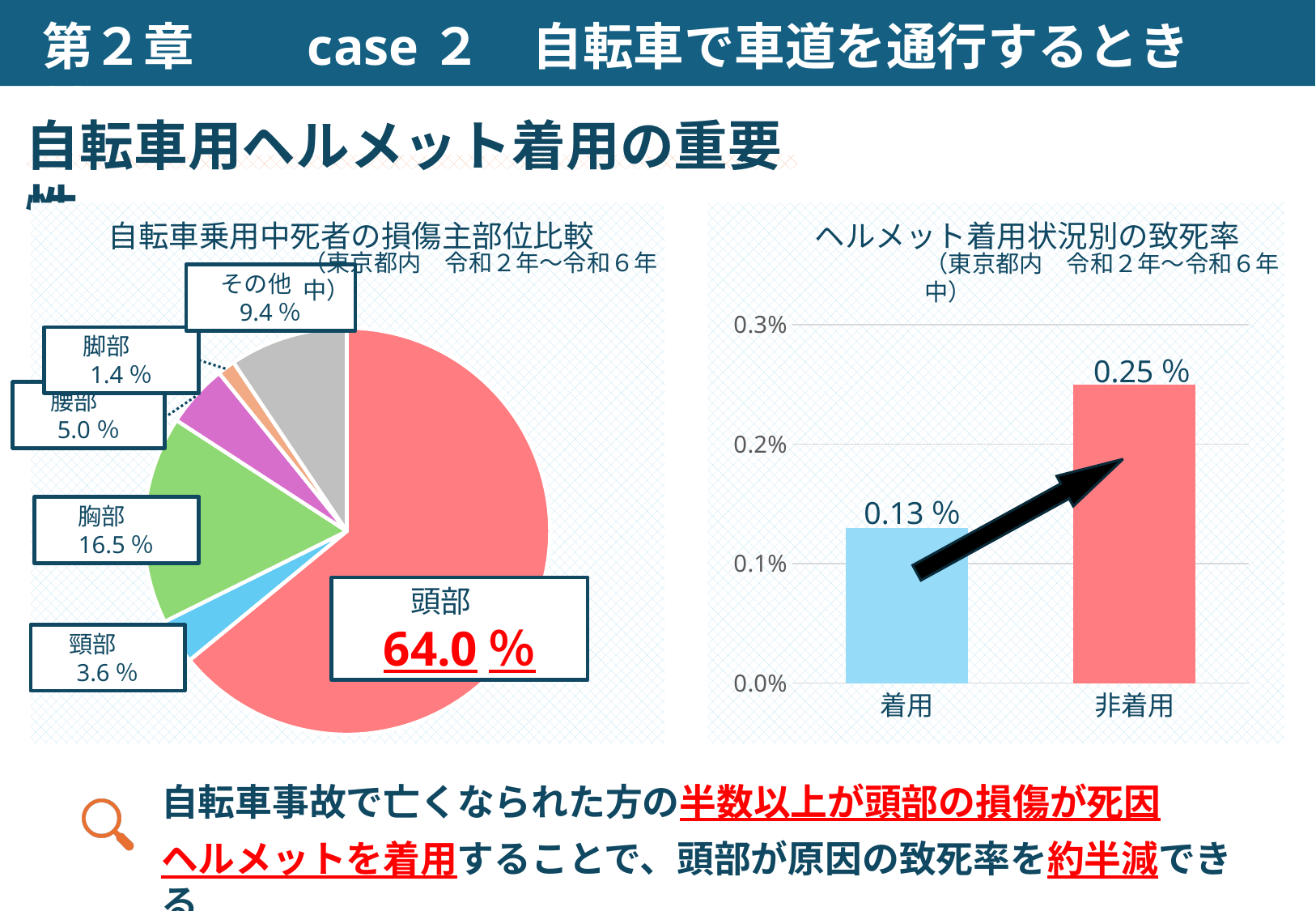
In the bar chart on the right, what is the fatality rate for 着用 (helmet worn)? 0.13 % In the pie chart on the left, what share of bicycle rider deaths had the head (頭部) as the main injury site? 64.0 % What kind of chart is the chart on the right? Bar chart In the bar chart on the right, what is the fatality rate for 非着用 (helmet not worn)? 0.25 % In the pie chart on the left, what is the difference between the shares for 胸部 and その他? 7.1 % In the pie chart on the left, which injury site has the smallest share? 脚部 In the pie chart on the left, which is larger, the share for 腰部 or the share for 頸部? 腰部 In the pie chart on the left, what percentage is shown for 脚部? 1.4 % In the pie chart on the left, what percentage is shown for 胸部? 16.5 % In the pie chart on the left, which injury site has the largest share? 頭部 In the bar chart on the right, what is the difference between the fatality rates for 非着用 and 着用? 0.12 % In the pie chart on the left, how many slices (injury categories) are labelled? 6